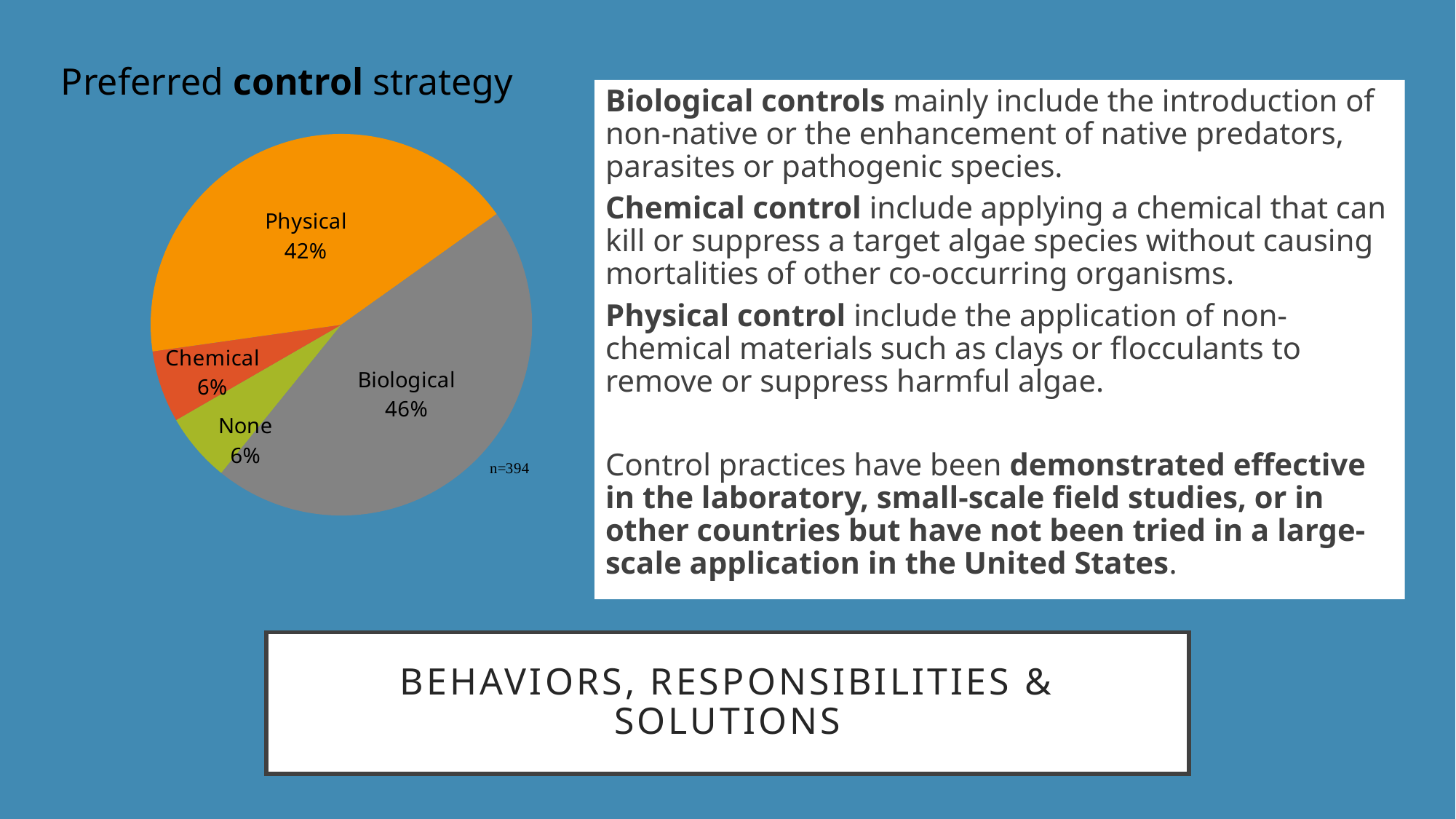
Which is larger, the Biological slice or the Physical slice? Biological How many categories are shown in the pie chart? 4 What share of the pie does Physical represent? 42% What is the difference between the Physical and Chemical shares? 36% What is the value shown for None? 6% Which category has the largest slice of the pie? Biological What share of the pie does Biological represent? 46% What is the title of the chart? Preferred control strategy What is the value shown for Chemical? 6% What is the difference between the Biological and Physical shares? 4% What sample size (n) is noted on the chart? n=394 What kind of chart is shown on the slide? Pie chart